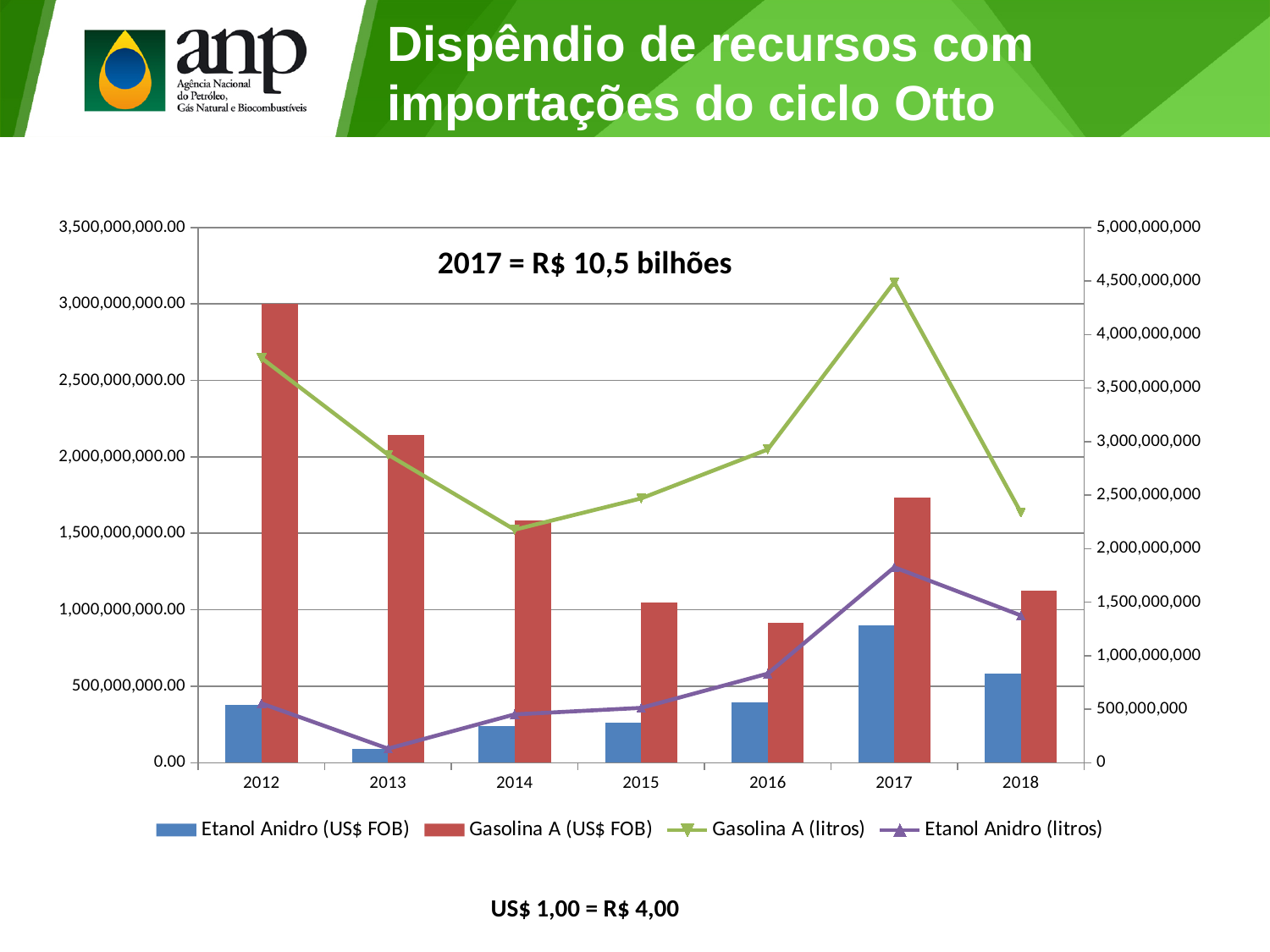
What kind of chart is shown on the slide? A combined bar and line chart In which year is the Etanol Anidro (litros) line at its lowest? 2013 Is the Gasolina A (US$ FOB) value for 2012 greater or less than 2,500,000,000.00? greater In which year is the Gasolina A (US$ FOB) bar the highest? 2012 In which year is the Etanol Anidro (US$ FOB) bar the lowest? 2013 In which year is the Etanol Anidro (US$ FOB) bar the highest? 2017 How many series does the legend list? 4 How many years are shown on the x axis? 7 Does the Gasolina A (US$ FOB) bar rise or fall from 2012 to 2016? fall Is the Gasolina A (litros) value for 2017 greater or less than 4,000,000,000? greater Which is larger, the Gasolina A (US$ FOB) bar for 2012 or for 2017? 2012 In which year does the Gasolina A (litros) line reach its peak? 2017